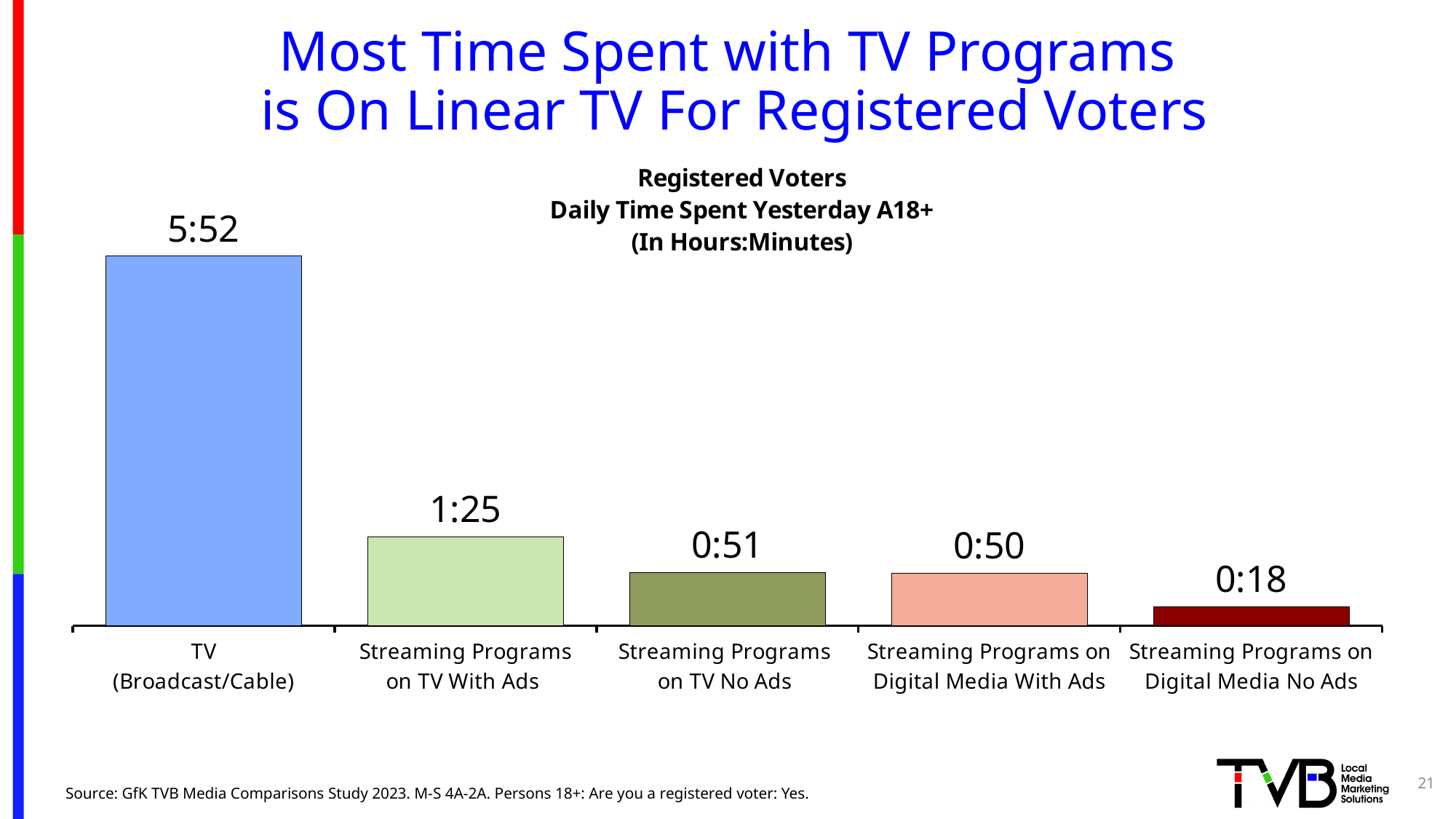
Which category has the highest daily time spent? TV (Broadcast/Cable) What type of chart is shown on the slide? Bar chart Which category has the lowest daily time spent? Streaming Programs on Digital Media No Ads What is the daily time spent with Streaming Programs on TV No Ads? 0:51 What is the daily time spent with TV (Broadcast/Cable) for registered voters? 5:52 In what units are the values in the chart expressed, according to the chart subtitle? Hours:Minutes Which is larger: daily time spent with Streaming Programs on TV With Ads or Streaming Programs on Digital Media No Ads? Streaming Programs on TV With Ads How many categories are shown in the chart? 5 How much more daily time is spent with TV (Broadcast/Cable) than with Streaming Programs on TV With Ads? 4:27 What is the daily time spent with Streaming Programs on Digital Media No Ads? 0:18 What is the daily time spent with Streaming Programs on Digital Media With Ads? 0:50 What is the daily time spent with Streaming Programs on TV With Ads? 1:25